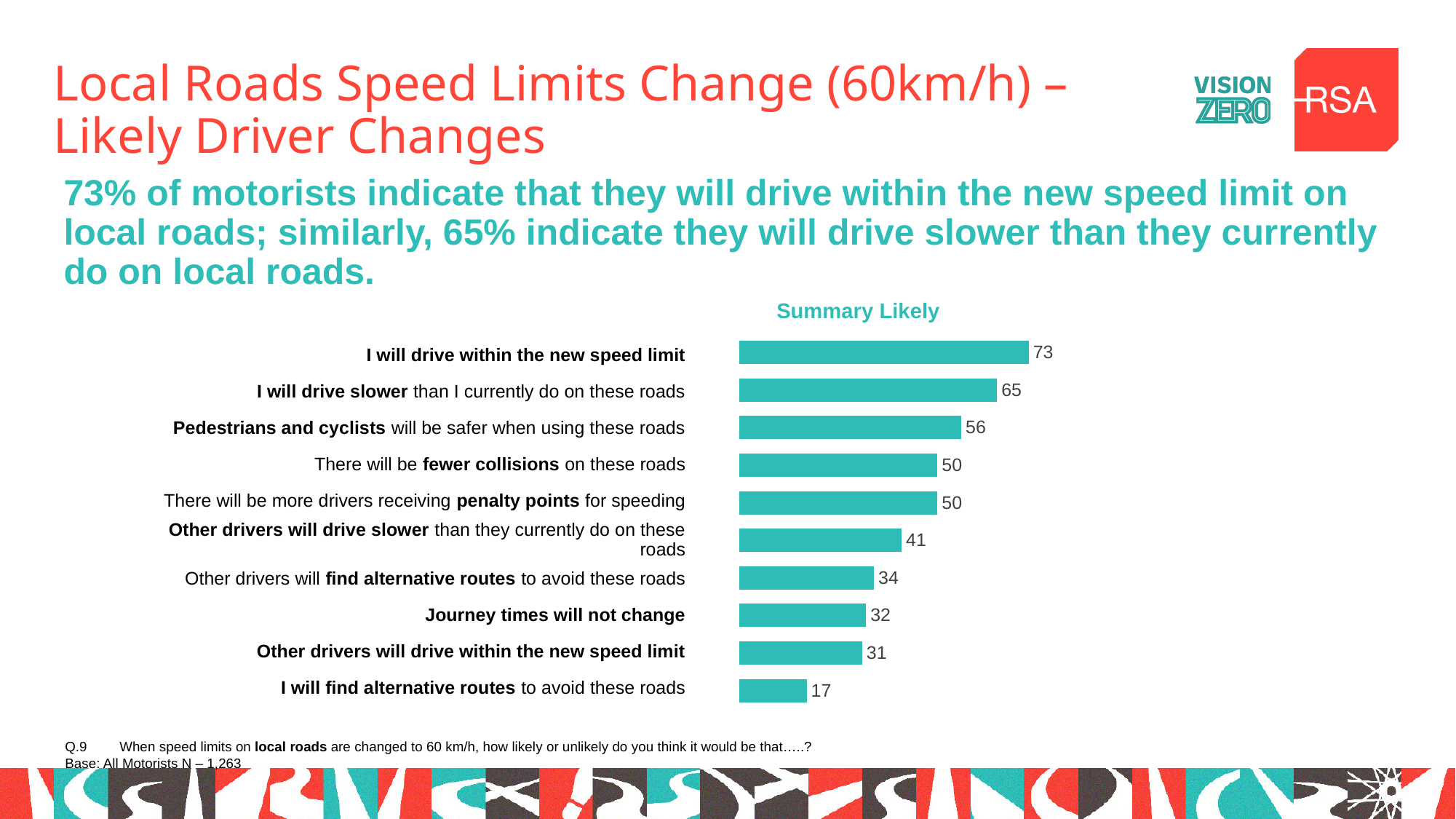
What is the value for "I will drive within the new speed limit"? 73 What is the difference between the values for "I will drive within the new speed limit" and "I will drive slower than I currently do on these roads"? 8 What is the value for "Other drivers will find alternative routes to avoid these roads"? 34 Which category has the highest value? I will drive within the new speed limit What is the value for "Journey times will not change"? 32 What is the title of the chart? Summary Likely How many categories are shown in the chart? 10 Which is larger: the value for "Other drivers will drive slower than they currently do on these roads" or the value for "Other drivers will drive within the new speed limit"? Other drivers will drive slower than they currently do on these roads What is the difference between the values for "Pedestrians and cyclists will be safer when using these roads" and "I will find alternative routes to avoid these roads"? 39 What kind of chart is shown on the slide? Bar chart Which two categories share the value 50? There will be fewer collisions on these roads; There will be more drivers receiving penalty points for speeding Which category has the lowest value? I will find alternative routes to avoid these roads